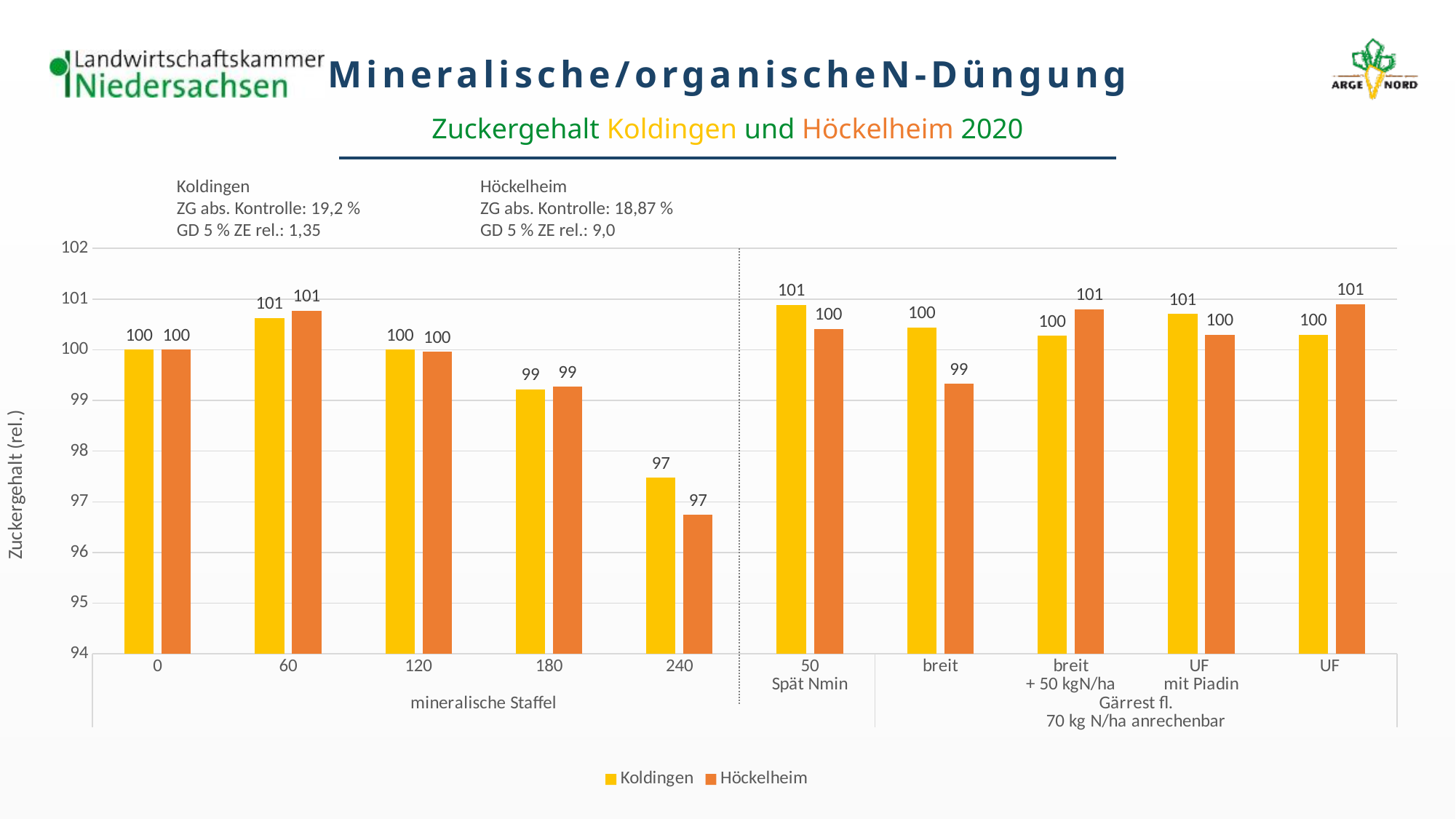
Which category has the lowest Höckelheim value? 240 How many series does the legend list? 2 What is the Höckelheim value for the category breit? 99 How many categories are shown on the x axis? 10 What kind of chart is shown on the slide? bar chart What is the Koldingen value for the category 240? 97 Is the Koldingen value for the category 240 greater or less than 98? less For the category breit, which series has the larger value, Koldingen or Höckelheim? Koldingen What is the Koldingen value for the category 50 Spät Nmin? 101 What is the difference between the Koldingen values for the categories 0 and 240? 3 What colour are the Höckelheim bars? orange Along the mineralische Staffel categories from 60 to 240, do the Koldingen values rise or fall? fall